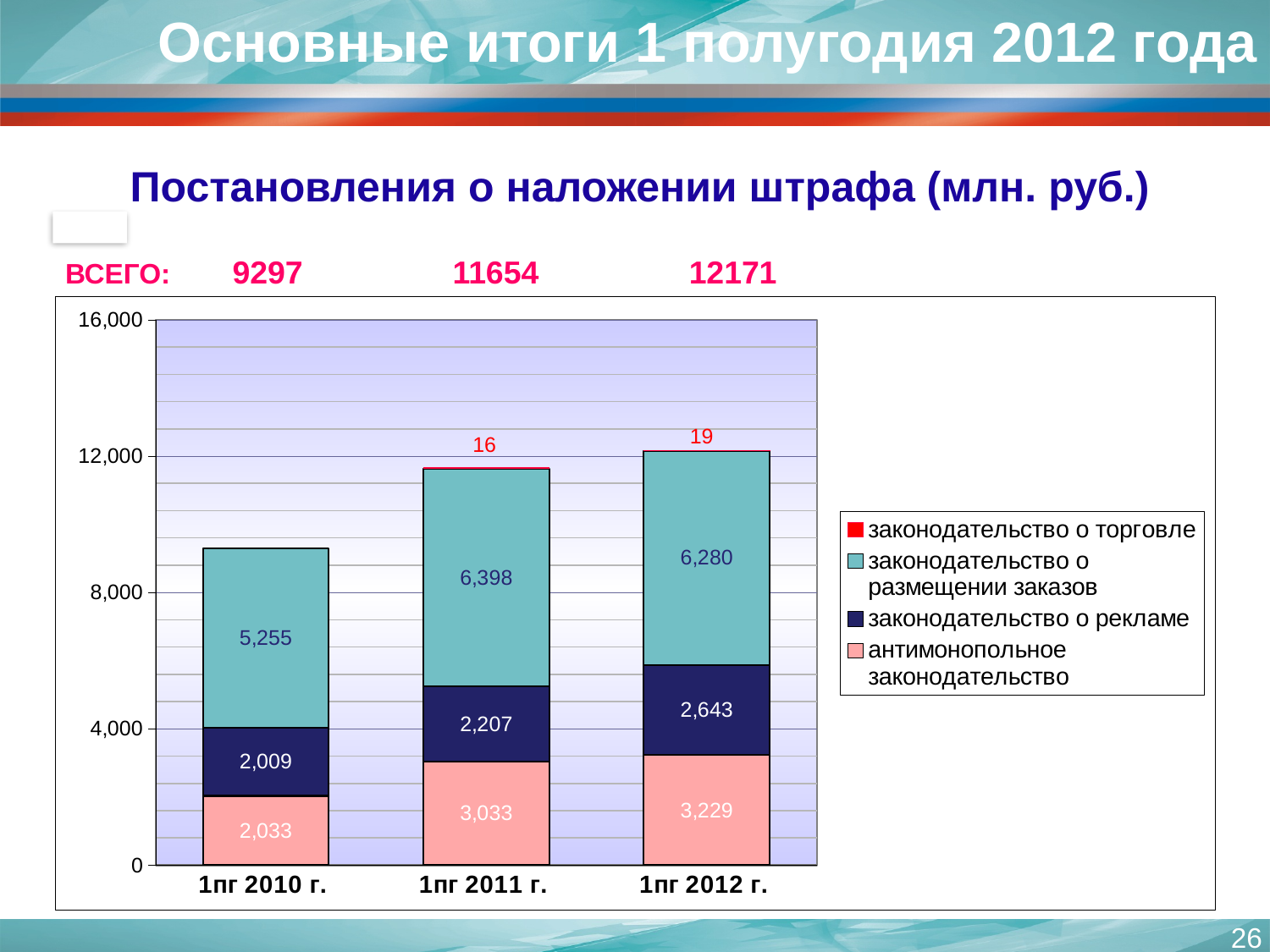
What is the value for законодательство о рекламе in 1пг 2010 г.? 2,009 Which period has the highest value for законодательство о размещении заказов? 1пг 2011 г. What type of chart is shown on the slide? stacked bar chart How many categories are shown on the x axis? 3 What is the difference between the антимонопольное законодательство values for 1пг 2012 г. and 1пг 2010 г.? 1,196 What is the value for законодательство о торговле in 1пг 2012 г.? 19 Which period has the lowest total? 1пг 2010 г. What is the value for антимонопольное законодательство in 1пг 2011 г.? 3,033 How many series does the legend list? 4 Do the stacked bar totals rise or fall from 1пг 2010 г. to 1пг 2012 г.? rise What is the value for законодательство о размещении заказов in 1пг 2012 г.? 6,280 What is the total of the stacked bar for 1пг 2011 г.? 11654